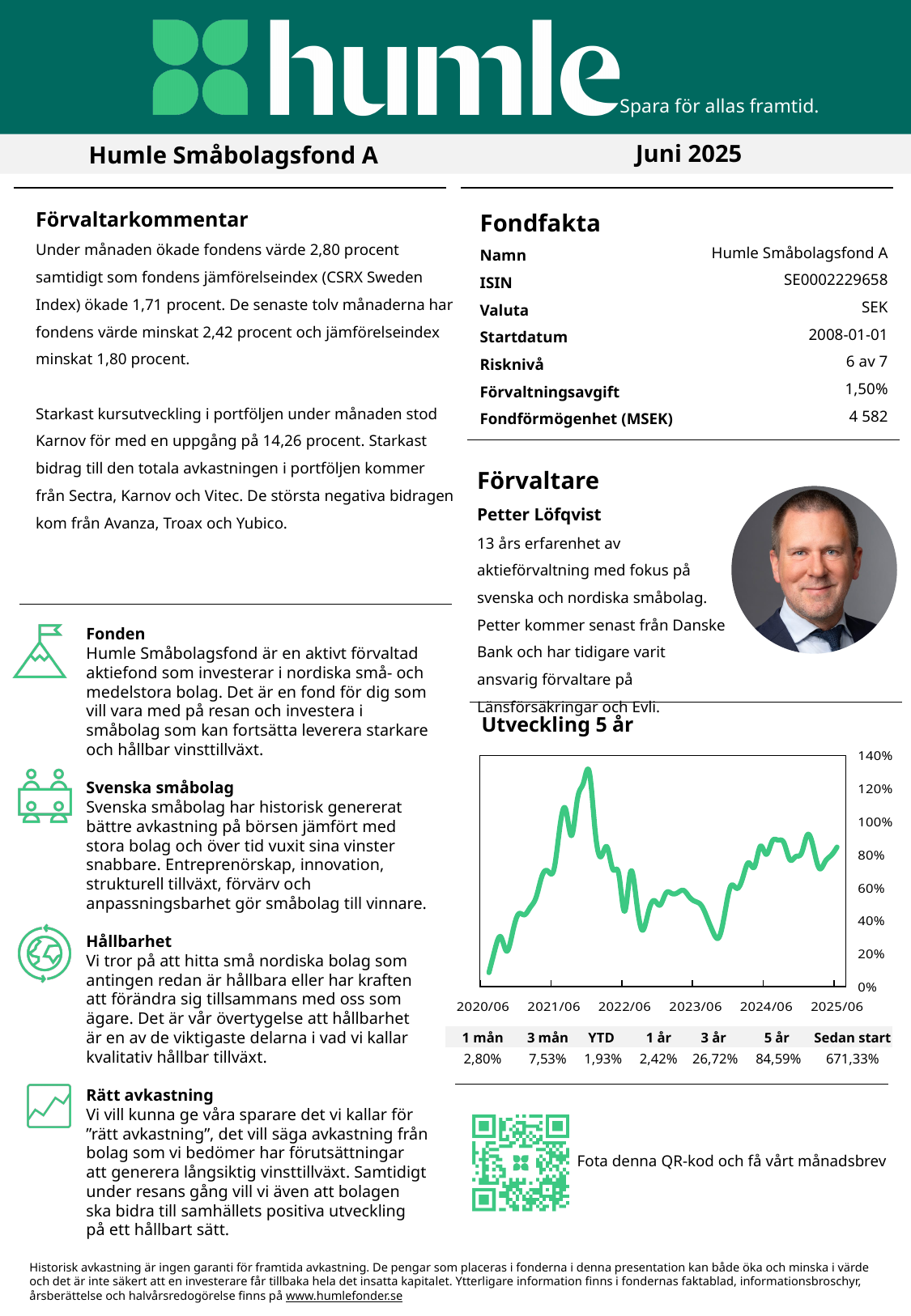
In the "Utveckling 5 år" chart, is the highest point of the line greater or less than 120%? greater In the "Utveckling 5 år" chart, is the value around 2023/06 greater or less than 40%? greater In the "Utveckling 5 år" chart, is the value at 2025/06 greater or less than 100%? less How many date labels are shown on the x axis of the "Utveckling 5 år" chart? 6 In the "Utveckling 5 år" chart, is the value at 2025/06 higher or lower than the value at 2020/06? higher What is the title of the chart on the slide? Utveckling 5 år What is the highest value shown on the y axis of the "Utveckling 5 år" chart? 140% What kind of chart is shown under the heading "Utveckling 5 år"? line chart In the "Utveckling 5 år" chart, does the line overall rise or fall from 2020/06 to 2025/06? rise